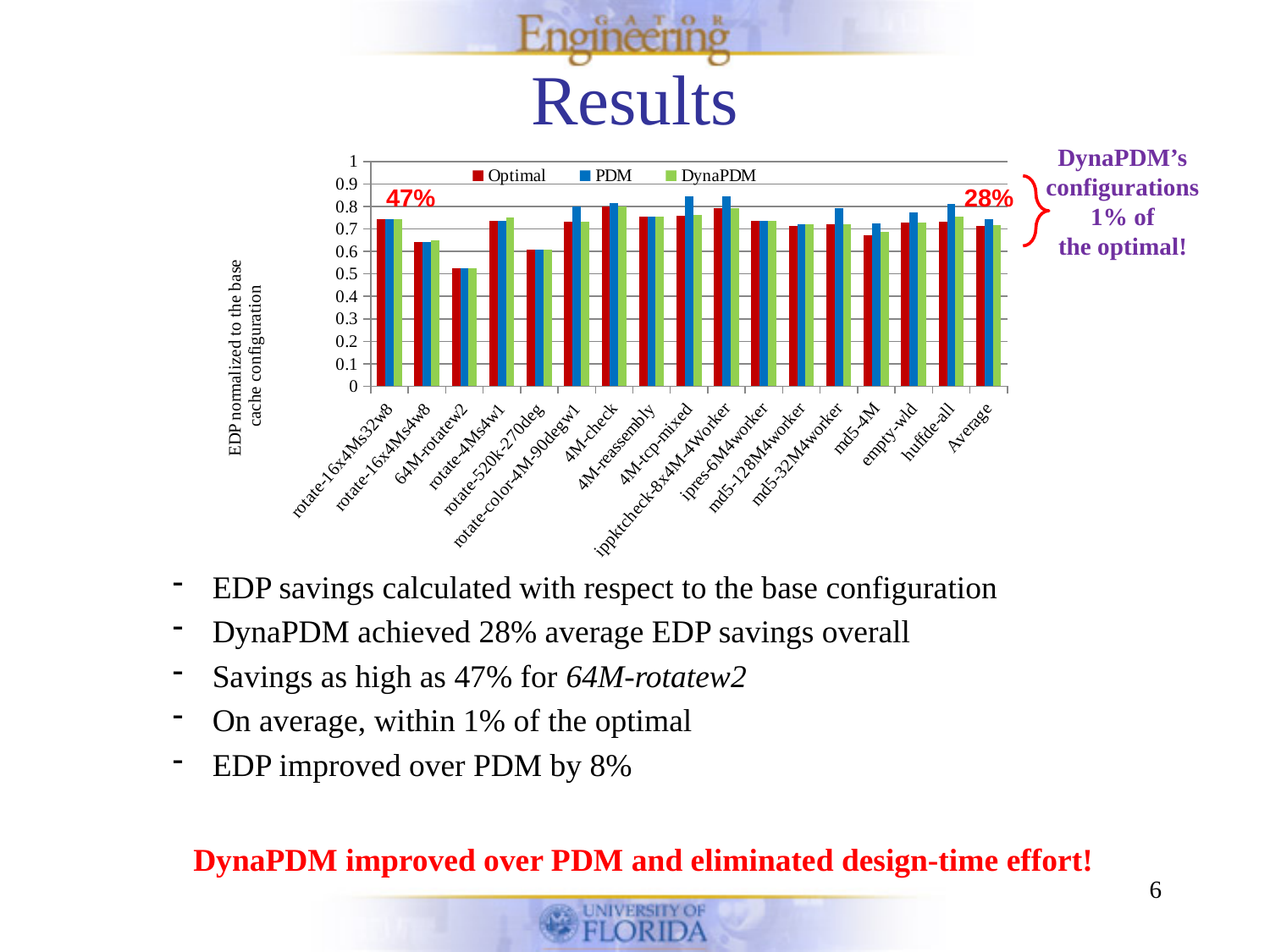
Is the Optimal value for 64M-rotatew2 greater or less than 0.5? greater Which has the larger DynaPDM value, 64M-rotatew2 or 4M-check? 4M-check Which category has the lowest bars in the chart? 64M-rotatew2 Is the DynaPDM value for Average greater or less than 0.8? less Which has the larger Optimal value, rotate-16x4Ms4w8 or rotate-4Ms4w1? rotate-4Ms4w1 Is the DynaPDM value for 64M-rotatew2 greater or less than 0.6? less How many categories are shown along the x axis of the chart? 17 How many series does the chart legend list? 3 What is the label on the y axis of the chart? EDP normalized to the base cache configuration What kind of chart is shown on the slide? bar chart Which series are listed in the chart legend? Optimal, PDM, DynaPDM